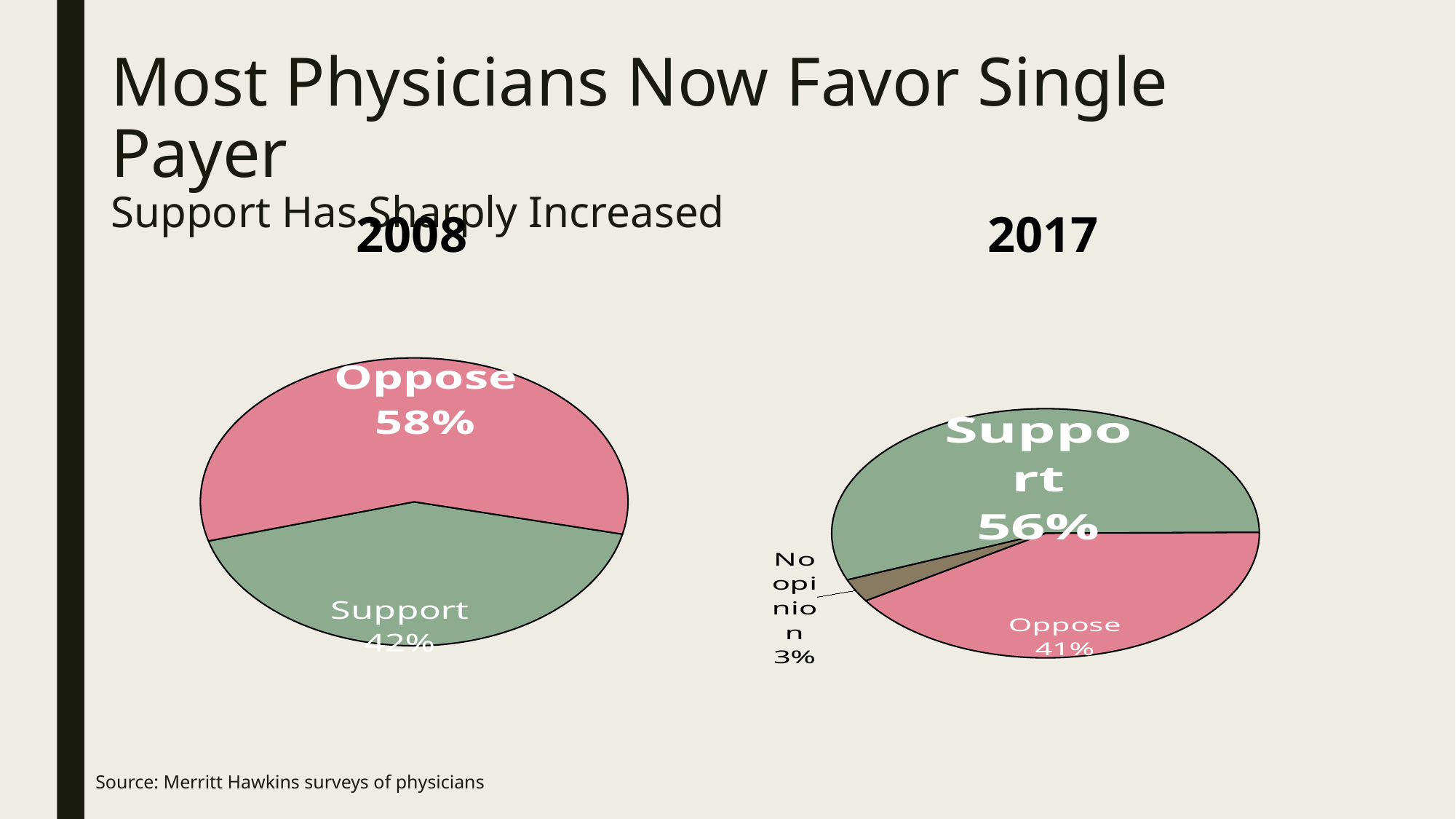
In the 2008 pie chart, what is the difference between the Oppose and Support percentages? 16% In the 2017 pie chart, which slice is the smallest? No opinion In the 2008 pie chart, which slice is the largest? Oppose In the 2008 pie chart, what percentage of physicians opposed single payer? 58% In the 2017 pie chart, what percentage of physicians had no opinion? 3% What type of chart is used for the 2008 data? Pie chart In the 2017 pie chart, which is larger, Support or Oppose? Support In the 2017 pie chart, what percentage of physicians opposed single payer? 41% In the 2017 pie chart, what percentage of physicians supported single payer? 56% In the 2008 pie chart, what percentage of physicians supported single payer? 42% How many slices does the 2017 pie chart have? 3 What is the source cited for the charts on the slide? Merritt Hawkins surveys of physicians